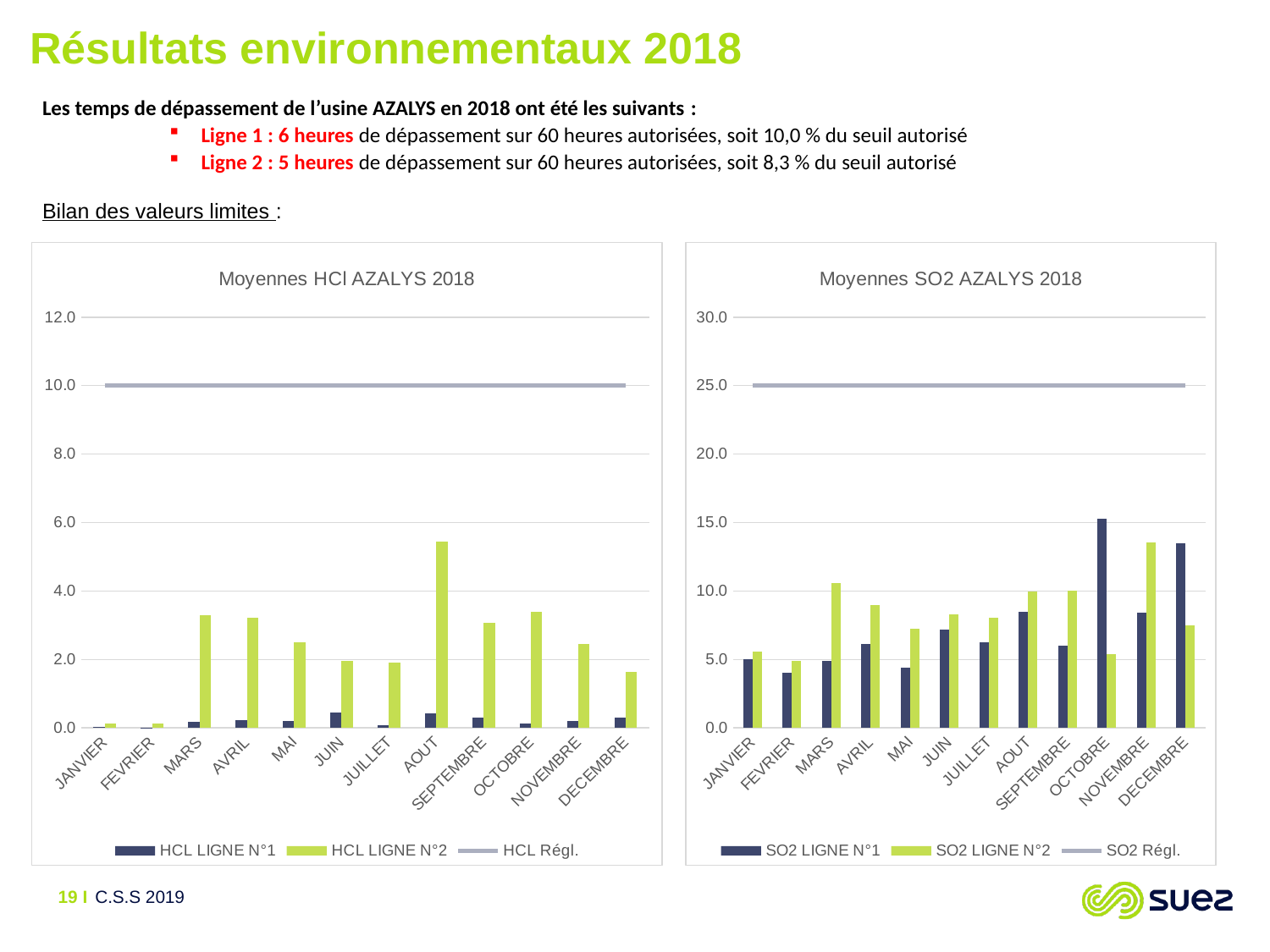
What kind of chart is the 'Moyennes HCl AZALYS 2018' chart? combination bar and line chart In the 'Moyennes SO2 AZALYS 2018' chart, what value does the SO2 Régl. line sit at? 25.0 How many series does the legend of the 'Moyennes SO2 AZALYS 2018' chart list? 3 In the 'Moyennes HCl AZALYS 2018' chart, is the HCL LIGNE N°2 value for AOUT greater or less than 4.0? greater In the 'Moyennes SO2 AZALYS 2018' chart, is the SO2 LIGNE N°1 value for OCTOBRE greater or less than 10.0? greater In the 'Moyennes HCl AZALYS 2018' chart, what value does the HCL Régl. line sit at? 10.0 In the 'Moyennes HCl AZALYS 2018' chart, which month has the highest HCL LIGNE N°2 value? AOUT In the 'Moyennes SO2 AZALYS 2018' chart, which is larger for OCTOBRE: SO2 LIGNE N°1 or SO2 LIGNE N°2? SO2 LIGNE N°1 In the 'Moyennes SO2 AZALYS 2018' chart, which month has the highest SO2 LIGNE N°1 value? OCTOBRE How many months are shown on the x axis of the 'Moyennes HCl AZALYS 2018' chart? 12 In the 'Moyennes HCl AZALYS 2018' chart, which is larger for MARS: HCL LIGNE N°1 or HCL LIGNE N°2? HCL LIGNE N°2 In the 'Moyennes SO2 AZALYS 2018' chart, which month has the highest SO2 LIGNE N°2 value? NOVEMBRE